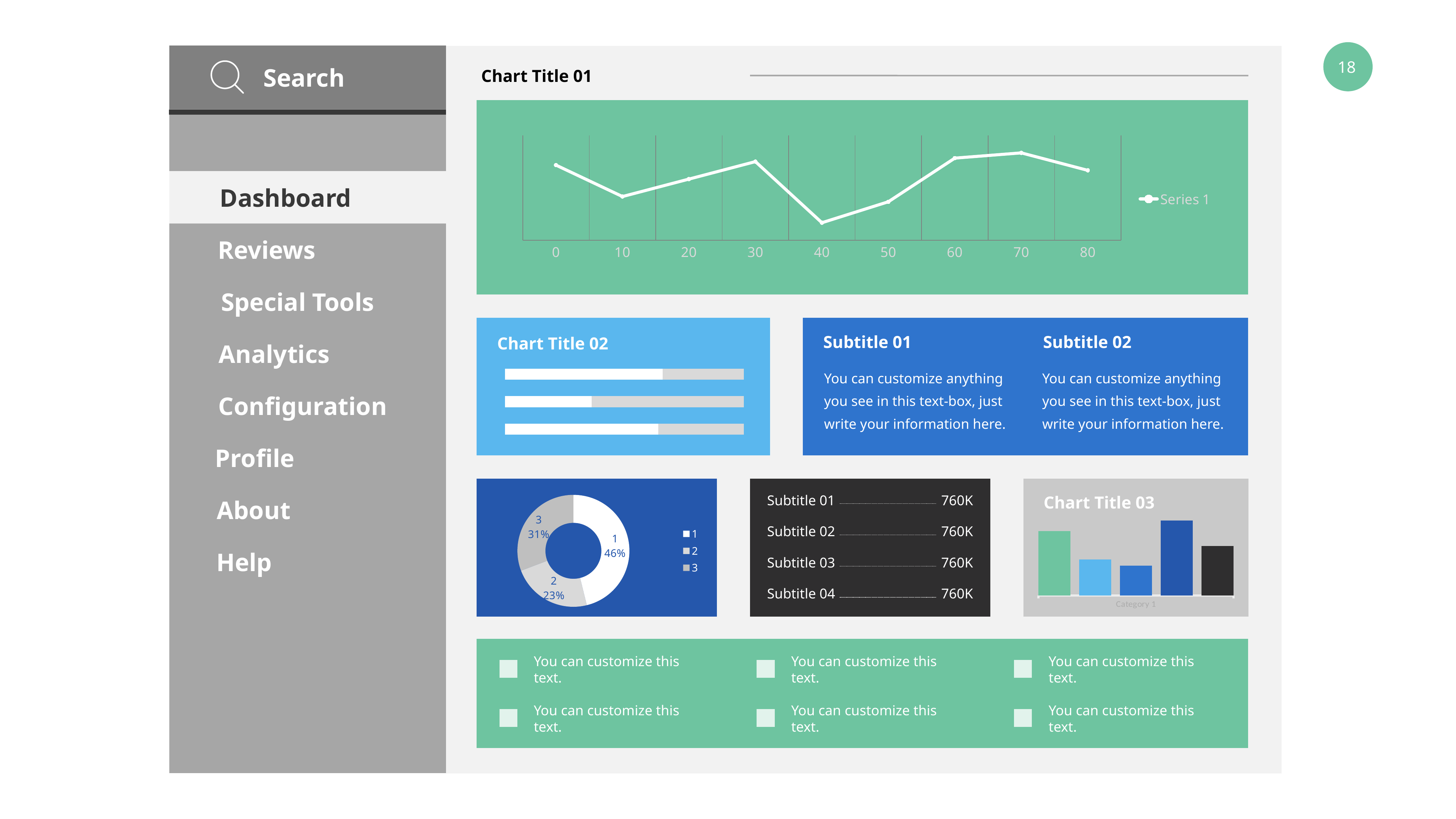
In Chart Title 01, at which x-axis value does the line reach its highest point? 70 In Chart Title 01, at which x-axis value does the line reach its lowest point? 40 In Chart Title 01, what kind of chart is shown? line chart In Chart Title 01, is the value at x = 30 larger or smaller than the value at x = 40? larger In Chart Title 01, how many series does the legend list? 1 In the doughnut chart at the bottom left, what share does slice 1 have? 46% In Chart Title 01, what is the name of the series in the legend? Series 1 In the doughnut chart at the bottom left, what share does slice 2 have? 23% In Chart Title 01, how many data points are plotted on the line? 9 In the doughnut chart at the bottom left, what is the difference between the shares of slice 3 and slice 2? 8% In the doughnut chart at the bottom left, which slice is the largest? 1 In Chart Title 03, how many bars are shown? 5